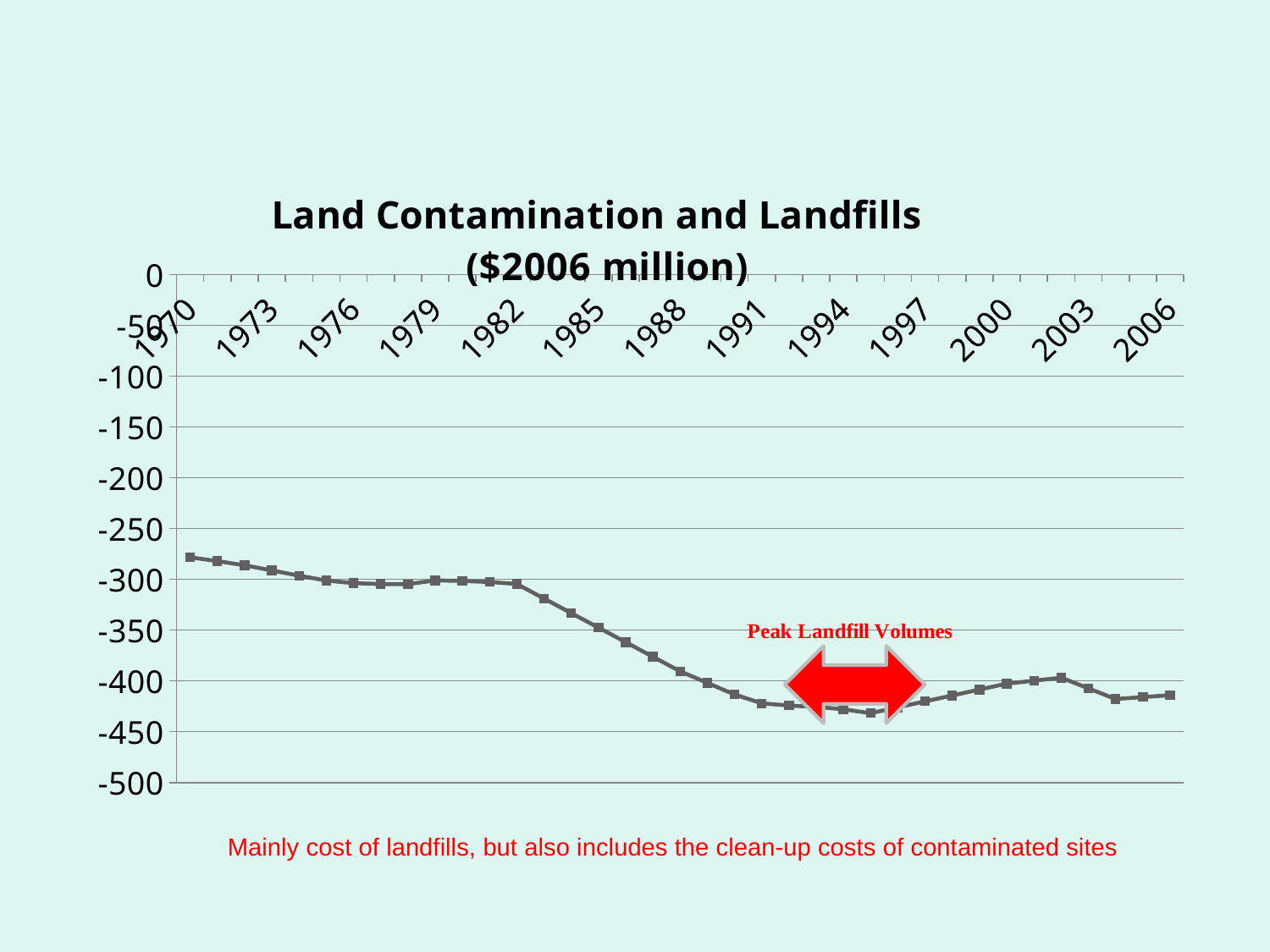
Which is larger, the value for 1982 or the value for 1991? 1982 Which year on the x axis has the highest (least negative) value? 1970 What does the red arrow annotation on the chart say? Peak Landfill Volumes What is the title of the chart? Land Contamination and Landfills ($2006 million) Do the values rise or fall between 1982 and 1991? fall How many year labels are shown on the x axis? 13 Is the value for 1988 greater or less than -350? less Is the value for 1979 greater or less than -350? greater Is the value for 1985 greater or less than -300? less What kind of chart is shown on the slide? line chart